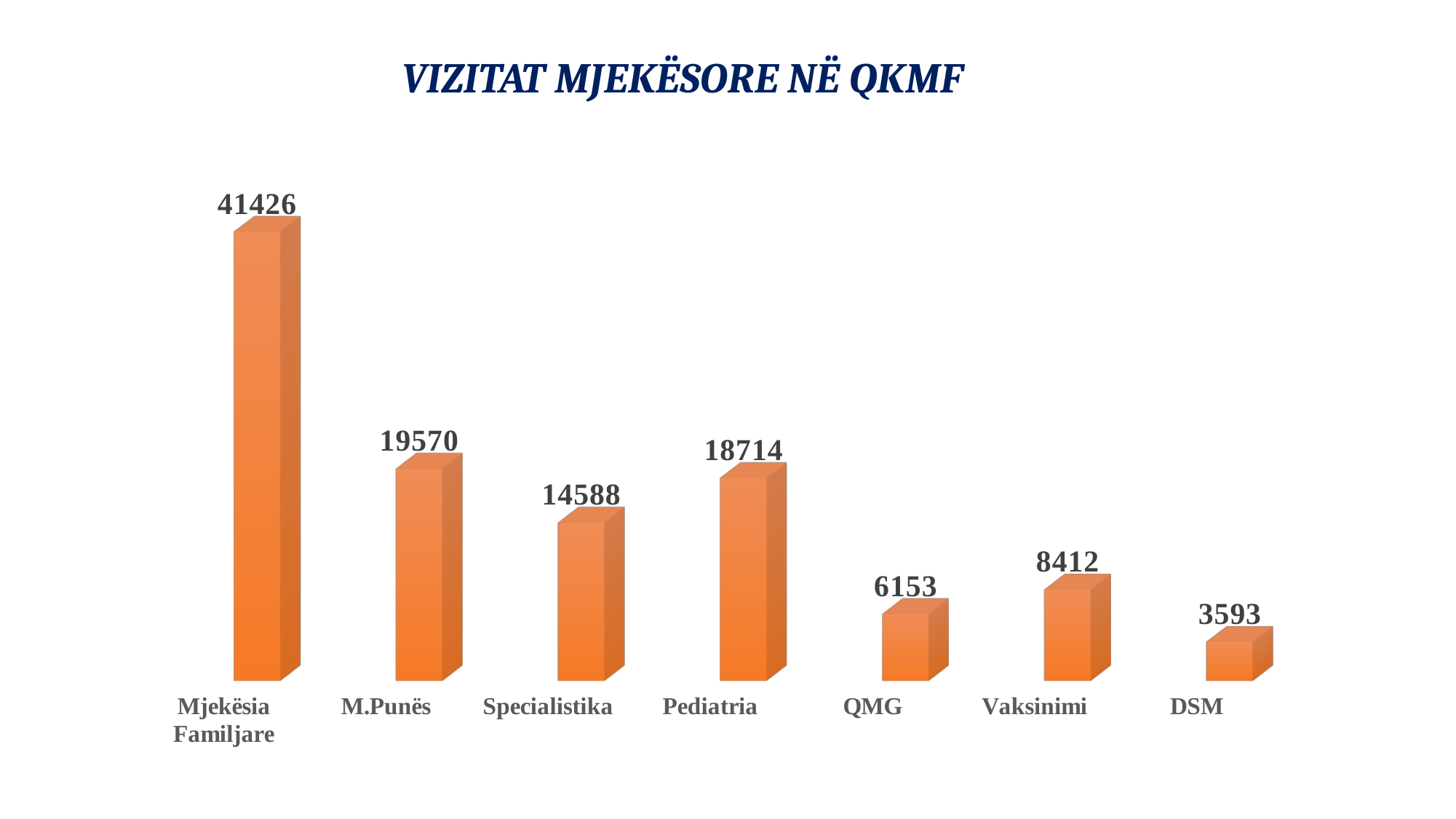
What is the value for Vaksinimi? 8412 What is the value for Pediatria? 18714 What is the difference between the values for Vaksinimi and QMG? 2259 What kind of chart is shown on the slide? bar chart Which category has the lowest value? DSM What is the difference between the values for M.Punës and Specialistika? 4982 How many categories are shown in the chart? 7 Which is larger, the value for M.Punës or the value for Pediatria? M.Punës Which category has the highest value? Mjekësia Familjare What is the title of the chart? VIZITAT MJEKËSORE NË QKMF What is the value for DSM? 3593 What is the value for Mjekësia Familjare? 41426